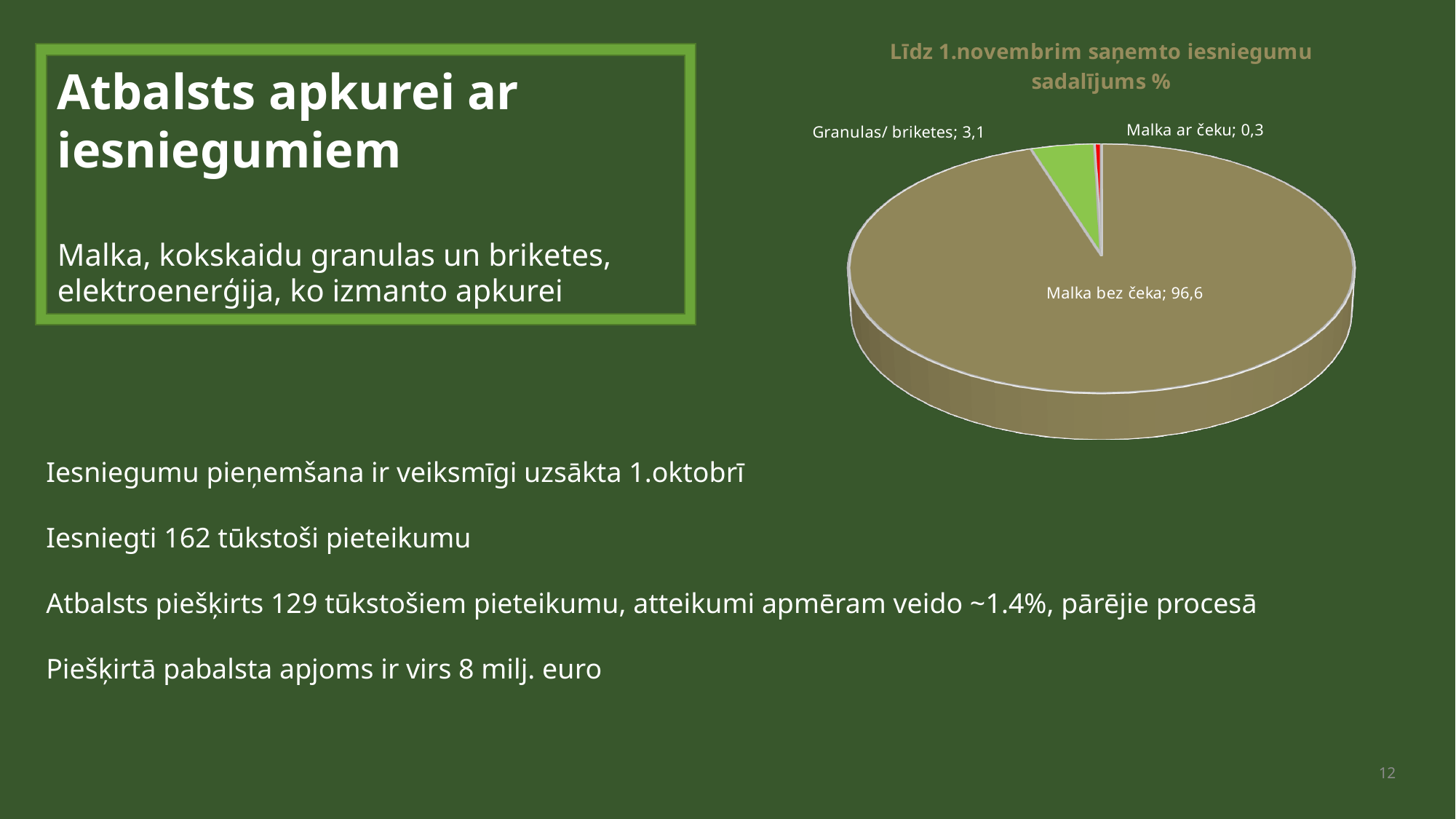
What kind of chart is shown on the slide? Pie chart What is the title of the chart? Līdz 1.novembrim saņemto iesniegumu sadalījums % Which category has the smallest share of the pie? Malka ar čeku What colour is the Granulas/ briketes slice? Green What is the difference between the values for Malka bez čeka and Granulas/ briketes? 93,5 How many slices does the pie chart have? 3 Which category has the largest share of the pie? Malka bez čeka What is the value for Malka bez čeka? 96,6 What is the difference between the values for Granulas/ briketes and Malka ar čeku? 2,8 What is the value for Granulas/ briketes? 3,1 Which is larger, the value for Granulas/ briketes or the value for Malka ar čeku? Granulas/ briketes What is the value for Malka ar čeku? 0,3